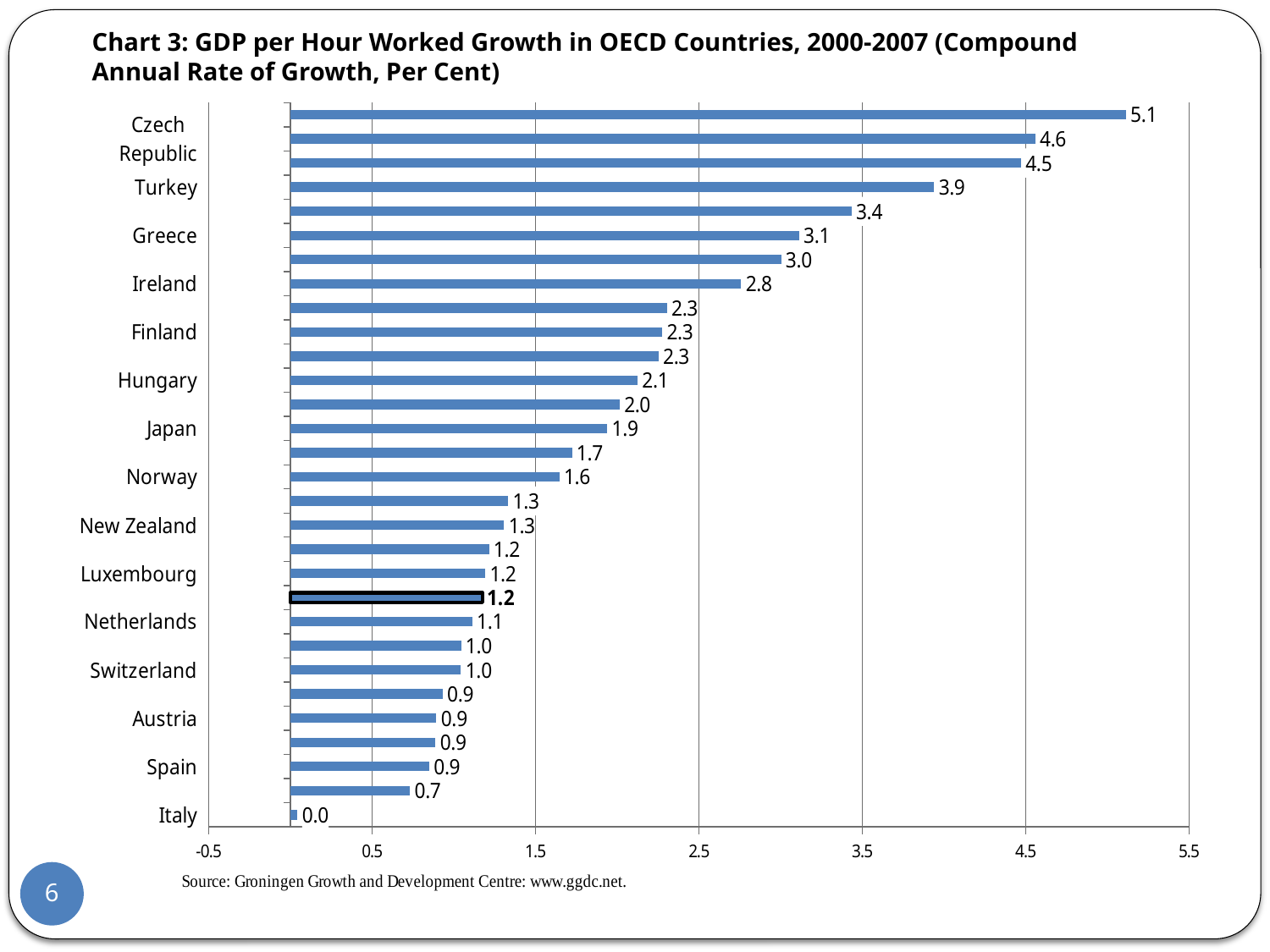
What is the highest value shown on the chart? 5.1 What is the value for Greece? 3.1 What is the value for Ireland? 2.8 Which is larger, the value for Ireland or the value for Japan? Ireland Which labelled country has the lowest value? Italy What is the value for Japan? 1.9 What is the value for Italy? 0.0 How many bars are plotted on the chart? 30 What kind of chart is shown on the slide? bar chart What is the value of the bar outlined in black? 1.2 What is the difference between the values for Turkey and Greece? 0.8 What is the value for Turkey? 3.9